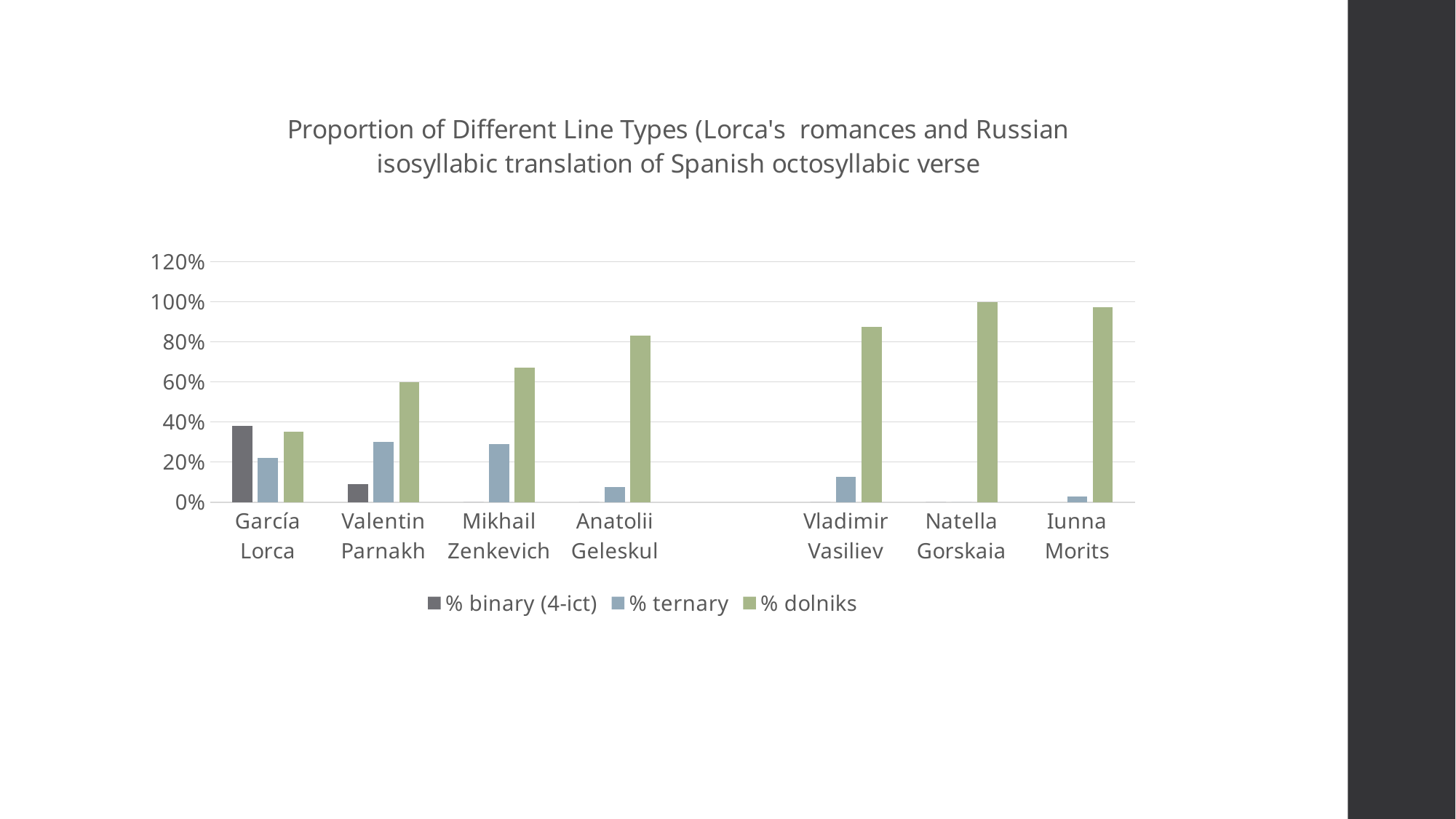
What is the % dolniks value for Natella Gorskaia? 100% What kind of chart is shown on the slide? bar chart Which category has the highest % binary (4-ict) value? García Lorca Is the % ternary value for Valentin Parnakh greater or less than 20%? greater Do the % dolniks values generally rise or fall from left to right along the x axis? rise Which has the larger % dolniks value: Mikhail Zenkevich or Anatolii Geleskul? Anatolii Geleskul How many labeled categories (authors/translators) are shown on the x axis? 7 Which category has the lowest % dolniks value? García Lorca Which is larger for García Lorca: % binary (4-ict) or % ternary? % binary (4-ict) Is the % dolniks value for Anatolii Geleskul greater or less than 80%? greater How many series does the legend list? 3